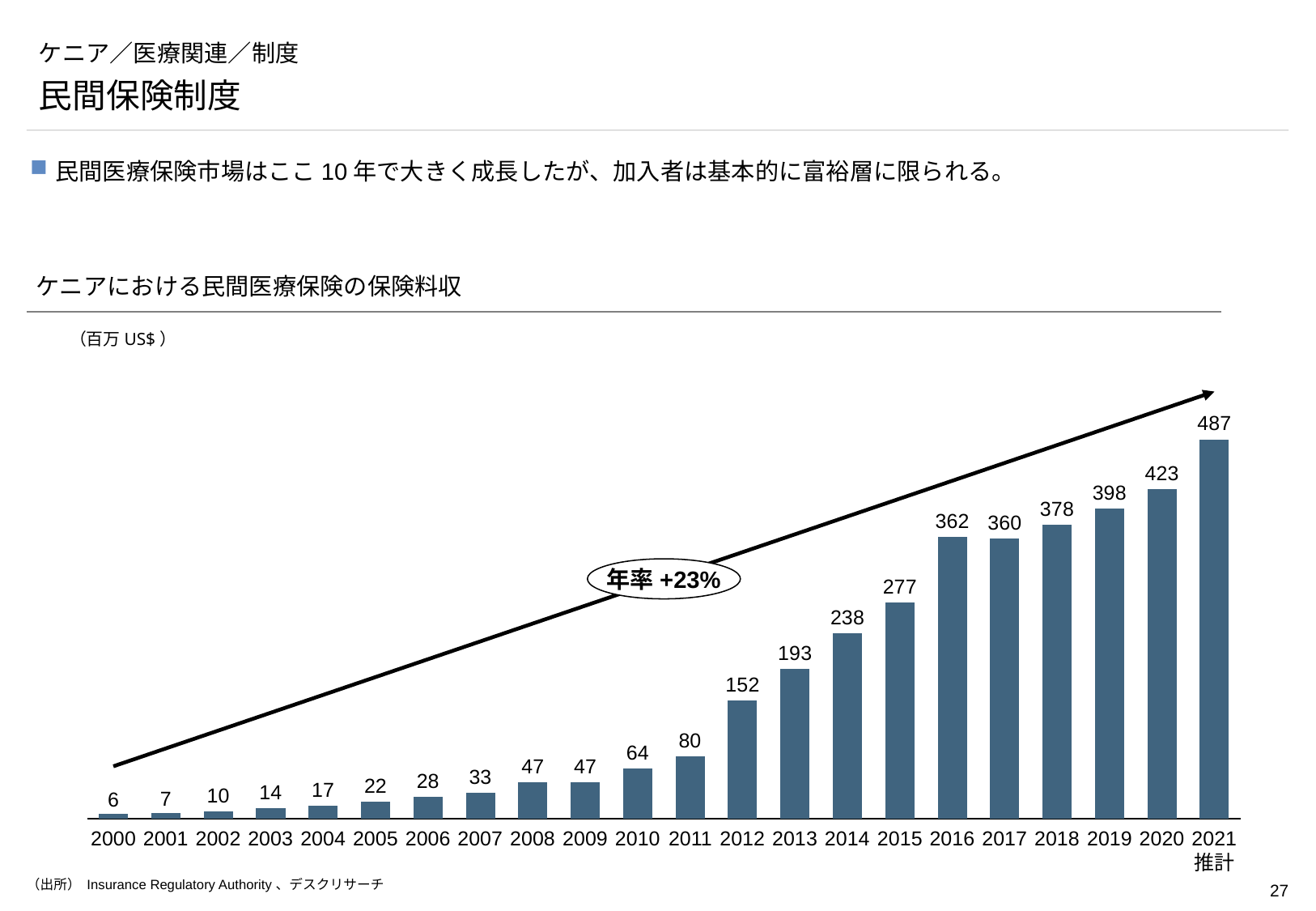
How many years are shown on the x axis? 22 What annual growth rate is shown in the oval label on the chart? 年率 +23% What unit is given for the chart values? 百万 US$ What is the value for 2000? 6 Do the values generally rise or fall from 2000 to 2021? rise What kind of chart is this? bar chart What is the value for 2012? 152 Which year has the lowest value? 2000 What is the value for 2021 推計? 487 Which is larger, the value for 2016 or the value for 2017? 2016 Which year has the highest value? 2021 推計 What is the difference between the values for 2020 and 2019? 25